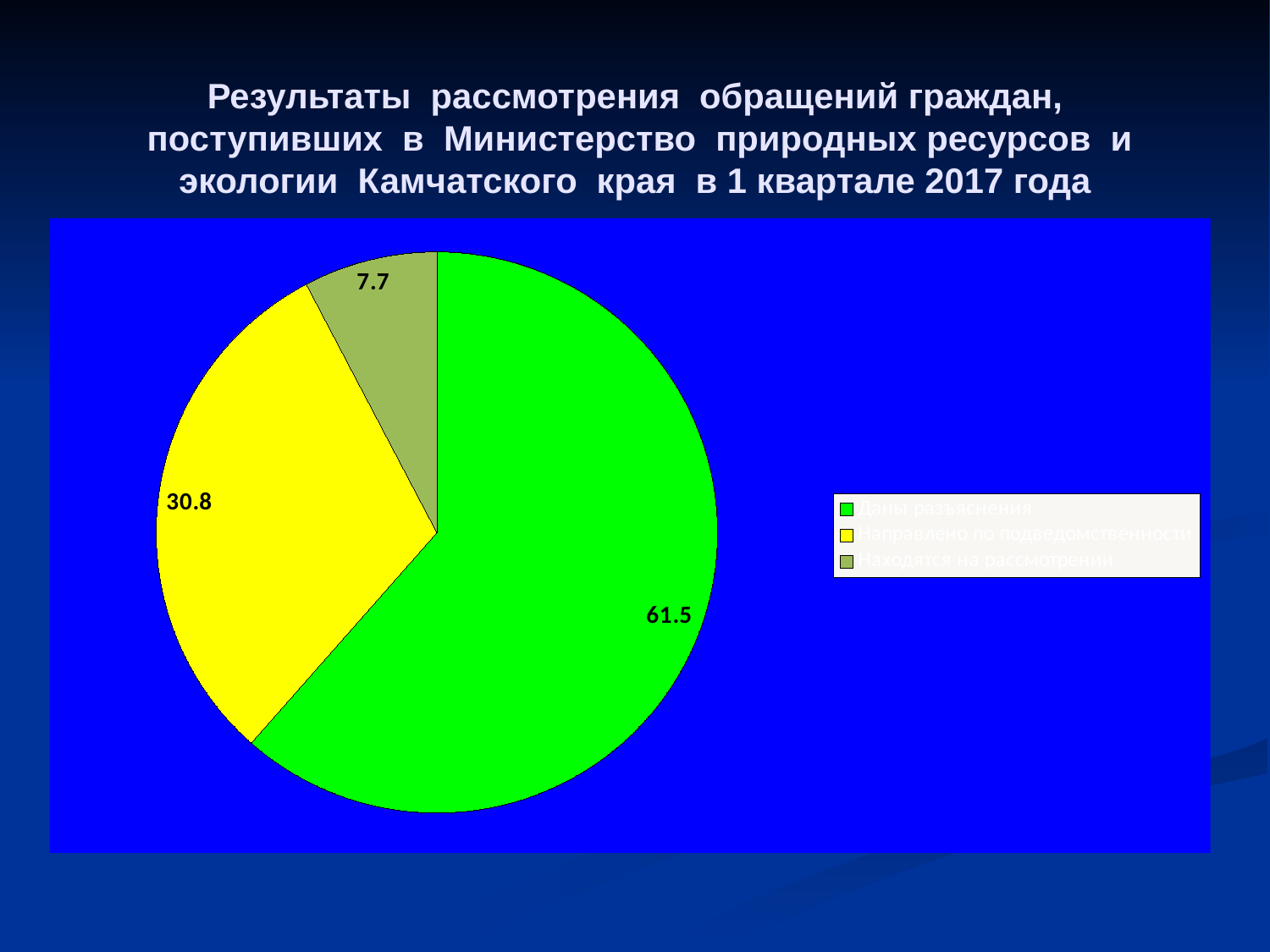
Which slice of the pie chart is the smallest? Находятся на рассмотрении Which is larger, the yellow slice or the olive-green slice? the yellow slice What value is shown on the green slice of the pie chart? 61.5 What is the value for 'Даны разъяснения'? 61.5 What is the value for 'Находятся на рассмотрении'? 7.7 What is the difference between the green slice (61.5) and the yellow slice (30.8)? 30.7 What value is shown on the olive-green slice of the pie chart? 7.7 Which slice of the pie chart is the largest? Даны разъяснения How many slices does the pie chart have? 3 What kind of chart is shown on the slide? pie chart What value is shown on the yellow slice of the pie chart? 30.8 How many entries does the legend list? 3